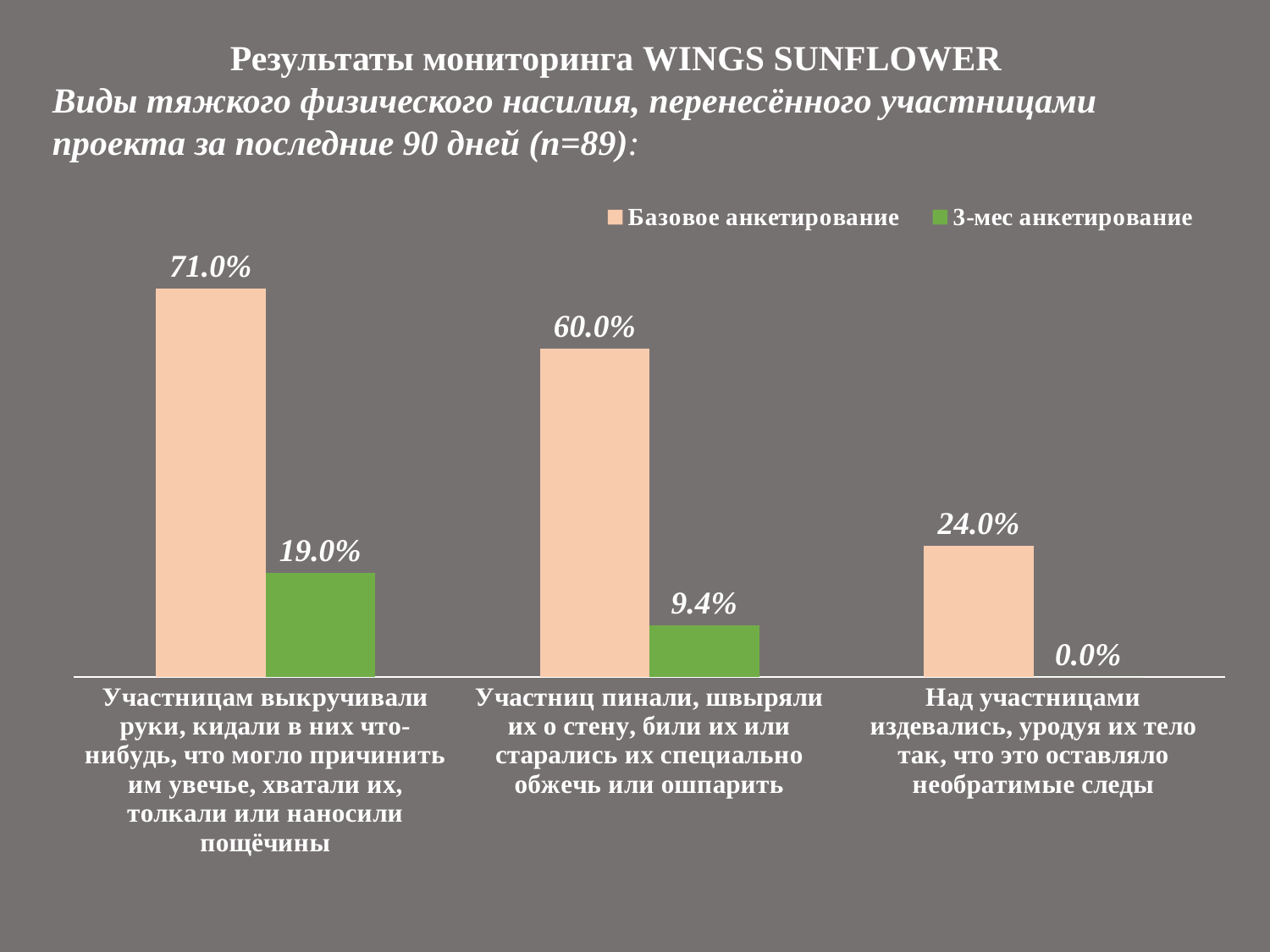
What is the value for 'Базовое анкетирование' for the category 'Над участницами издевались, уродуя их тело так, что это оставляло необратимые следы'? 24.0% What is the difference between the 'Базовое анкетирование' and '3-мес анкетирование' values for the category 'Участницам выкручивали руки, кидали в них что-нибудь, что могло причинить им увечье, хватали их, толкали или наносили пощёчины'? 52.0% What kind of chart is shown on the slide? Bar chart What is the difference between the 'Базовое анкетирование' values for 'Участницам выкручивали руки...' and 'Участниц пинали, швыряли их о стену...'? 11.0% What is the value for '3-мес анкетирование' for the category 'Над участницами издевались, уродуя их тело так, что это оставляло необратимые следы'? 0.0% Which is larger: the '3-мес анкетирование' value for 'Участницам выкручивали руки...' or for 'Участниц пинали, швыряли их о стену...'? Участницам выкручивали руки, кидали в них что-нибудь, что могло причинить им увечье, хватали их, толкали или наносили пощёчины How many categories are shown on the x axis? 3 What is the value for 'Базовое анкетирование' for the category 'Участницам выкручивали руки, кидали в них что-нибудь, что могло причинить им увечье, хватали их, толкали или наносили пощёчины'? 71.0% How many series does the legend list? 2 Which category has the highest value for 'Базовое анкетирование'? Участницам выкручивали руки, кидали в них что-нибудь, что могло причинить им увечье, хватали их, толкали или наносили пощёчины Which category has the lowest value for '3-мес анкетирование'? Над участницами издевались, уродуя их тело так, что это оставляло необратимые следы What is the value for '3-мес анкетирование' for the category 'Участниц пинали, швыряли их о стену, били их или старались их специально обжечь или ошпарить'? 9.4%